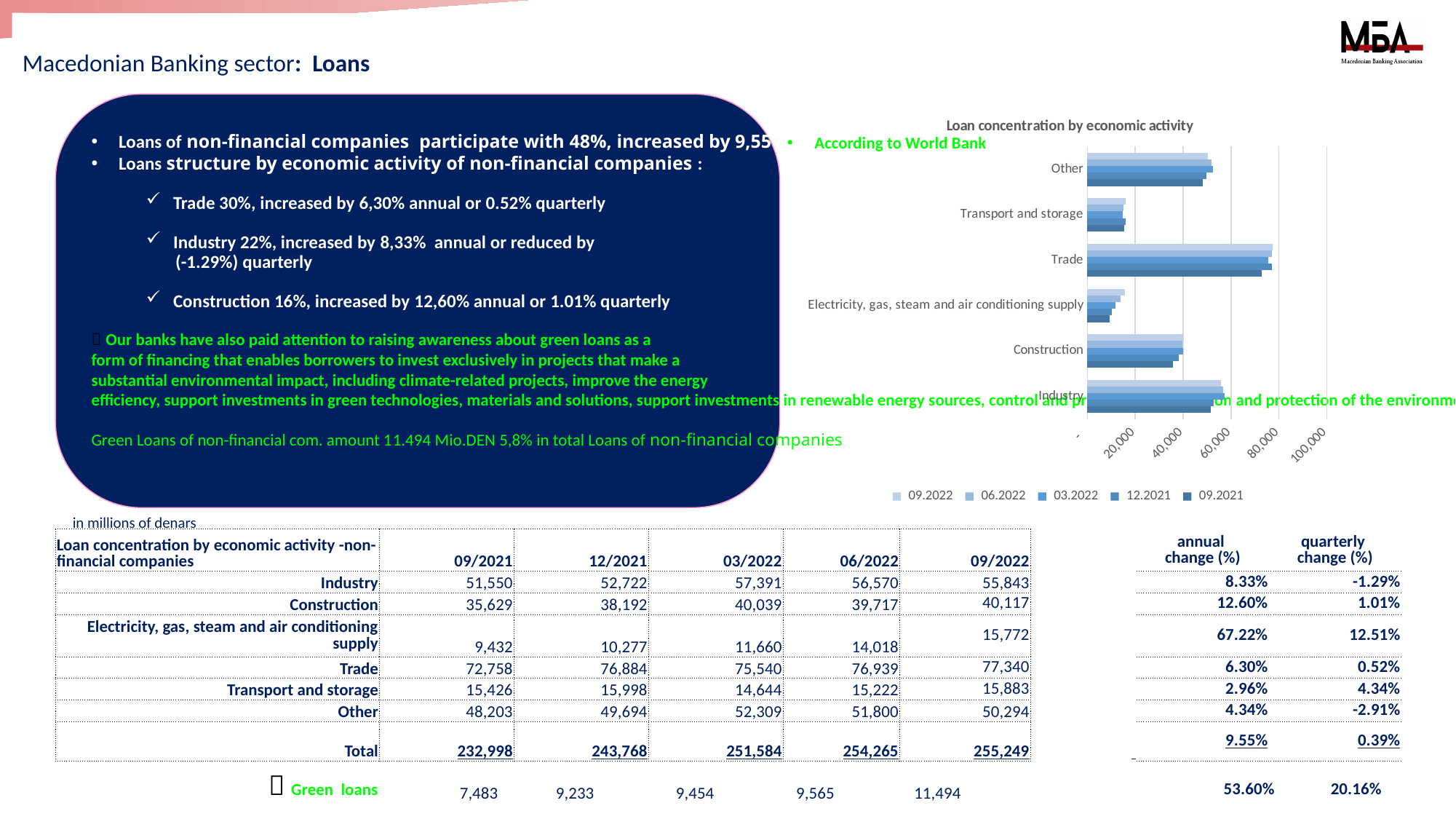
On the 'Loan concentration by economic activity' chart, which is larger for 09.2022: Industry or Construction? Industry According to the table on the slide, what is the loan value for Trade in 09/2022 (in millions of denars)? 77,340 On the 'Loan concentration by economic activity' chart, is the value for Transport and storage in 09.2022 greater or less than 20,000? less Which series is listed first in the legend of the 'Loan concentration by economic activity' chart? 09.2022 How many series does the legend of the 'Loan concentration by economic activity' chart list? 5 Which economic activity has the highest loan values on the 'Loan concentration by economic activity' chart? Trade On the 'Loan concentration by economic activity' chart, is the value for Industry in 09.2022 greater or less than 40,000? greater What kind of chart is 'Loan concentration by economic activity'? bar chart According to the table on the slide, what is the difference between the Industry loan value in 09/2022 and in 09/2021? 4,293 On the 'Loan concentration by economic activity' chart, is the value for Trade in 09.2022 greater or less than 80,000? less Which economic activity has the lowest value for the 09.2021 series on the 'Loan concentration by economic activity' chart? Electricity, gas, steam and air conditioning supply How many economic activity categories are shown on the 'Loan concentration by economic activity' chart? 6